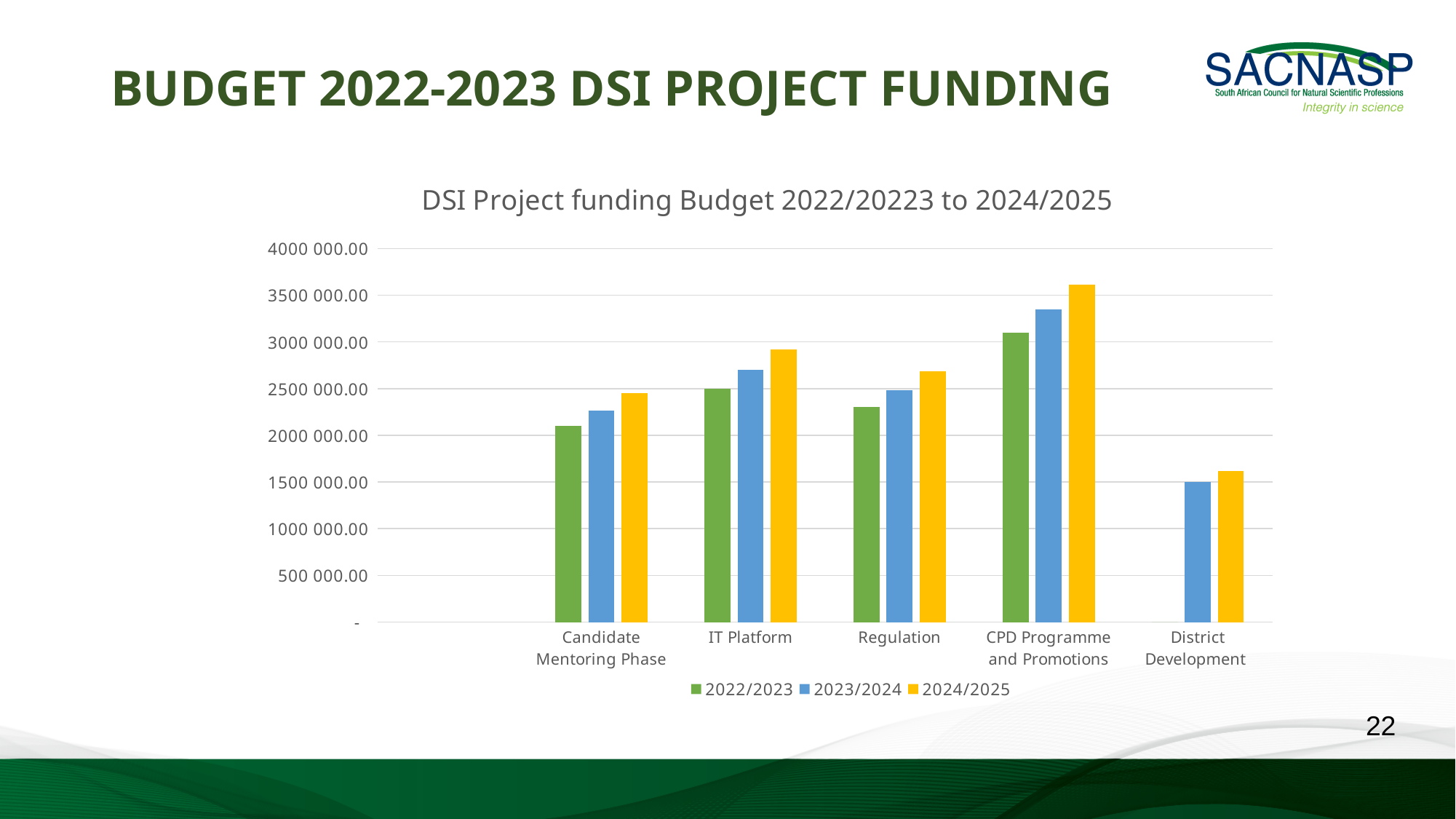
Which category has the lowest 2023/2024 value? District Development Which category has no 2022/2023 bar? District Development How many series does the legend list? 3 Do the values for IT Platform rise or fall from 2022/2023 to 2024/2025? rise Which category has the highest 2024/2025 value? CPD Programme and Promotions What is the title of the chart? DSI Project funding Budget 2022/20223 to 2024/2025 Is the 2024/2025 value for District Development greater or less than 2000 000.00? less What kind of chart is shown on the slide? bar chart Is the 2022/2023 value for Candidate Mentoring Phase greater or less than 2500 000.00? less How many categories are shown on the x axis? 5 Is the 2024/2025 value for CPD Programme and Promotions greater or less than 3500 000.00? greater Which is larger for Regulation: the 2022/2023 value or the 2024/2025 value? 2024/2025